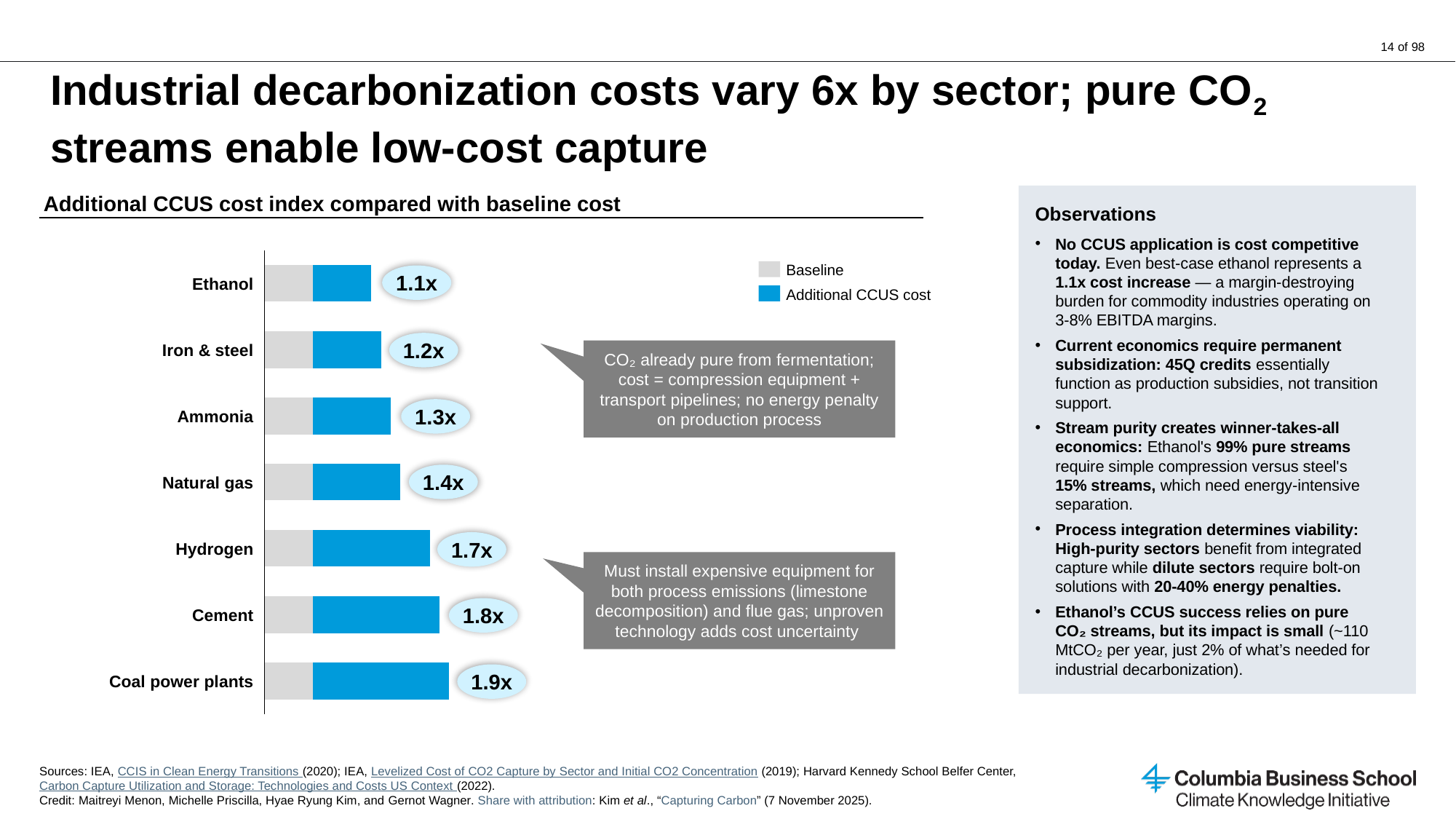
How many sectors are shown in the chart? 7 What is the cost index shown for Ethanol? 1.1x How many series does the chart legend list? 2 What is the cost index shown for Natural gas? 1.4x What kind of chart is shown on the slide? Stacked bar chart What is the cost index shown for Cement? 1.8x What are the two series named in the chart legend? Baseline and Additional CCUS cost Which has a higher cost index, Iron & steel or Ammonia? Ammonia Which sector has the lowest cost index in the chart? Ethanol Which sector has the highest cost index in the chart? Coal power plants What is the difference between the cost index for Coal power plants and the cost index for Ethanol? 0.8x What is the cost index shown for Hydrogen? 1.7x